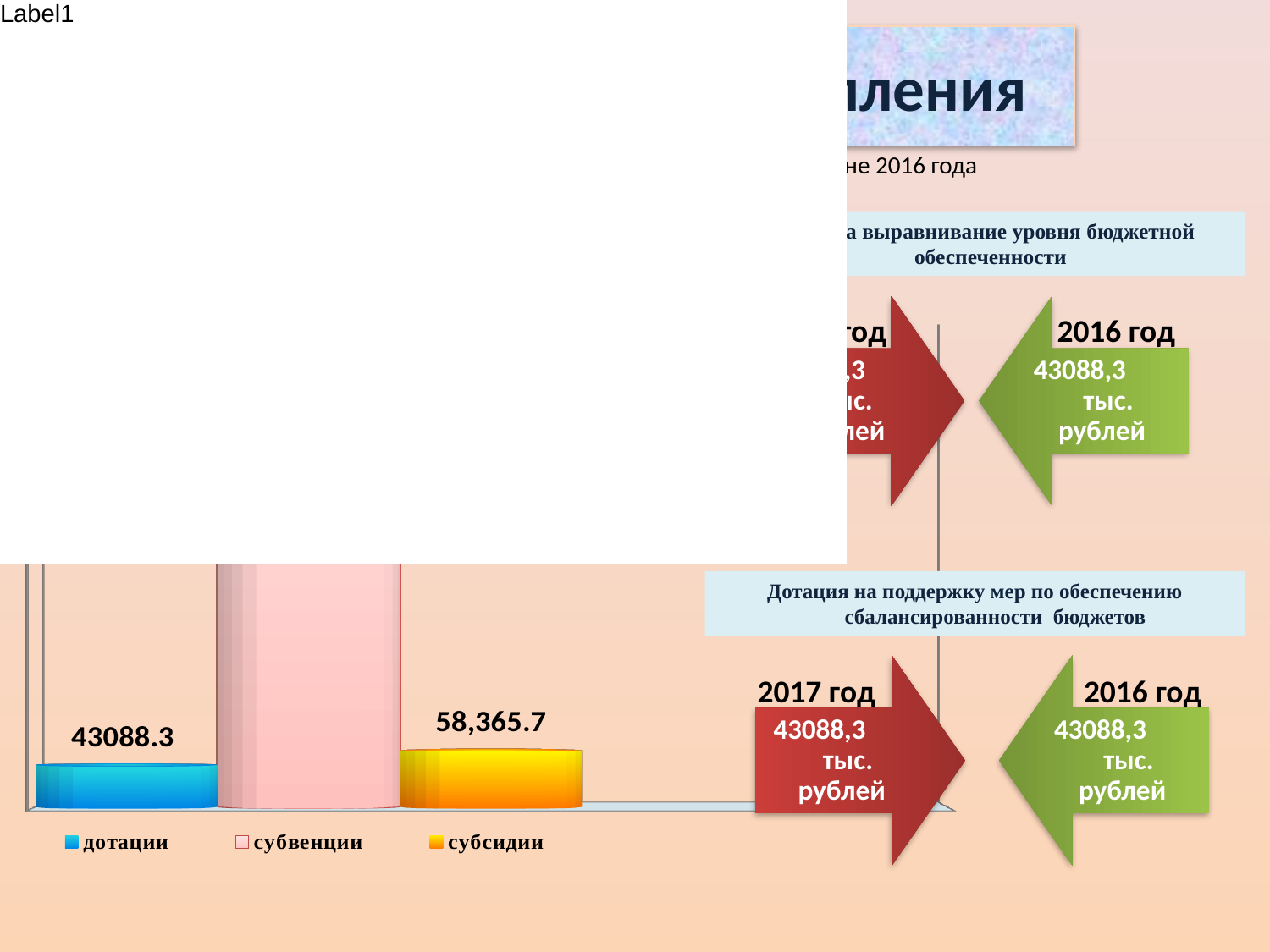
What is the value shown for субсидии in the bar chart? 58,365.7 How many bars are plotted in the chart? 3 What colour is the bar for субвенции in the chart? pink What kind of chart is shown on the slide? bar chart Which series has the shortest bar in the chart? дотации How many series does the chart legend list? 3 Which is larger in the bar chart, дотации or субсидии? субсидии What is the difference between the values for субсидии and дотации in the bar chart? 15,277.4 Which series has the tallest bar in the chart? субвенции What is the value shown for дотации in the bar chart? 43088.3 What colour is the bar for субсидии in the chart? yellow